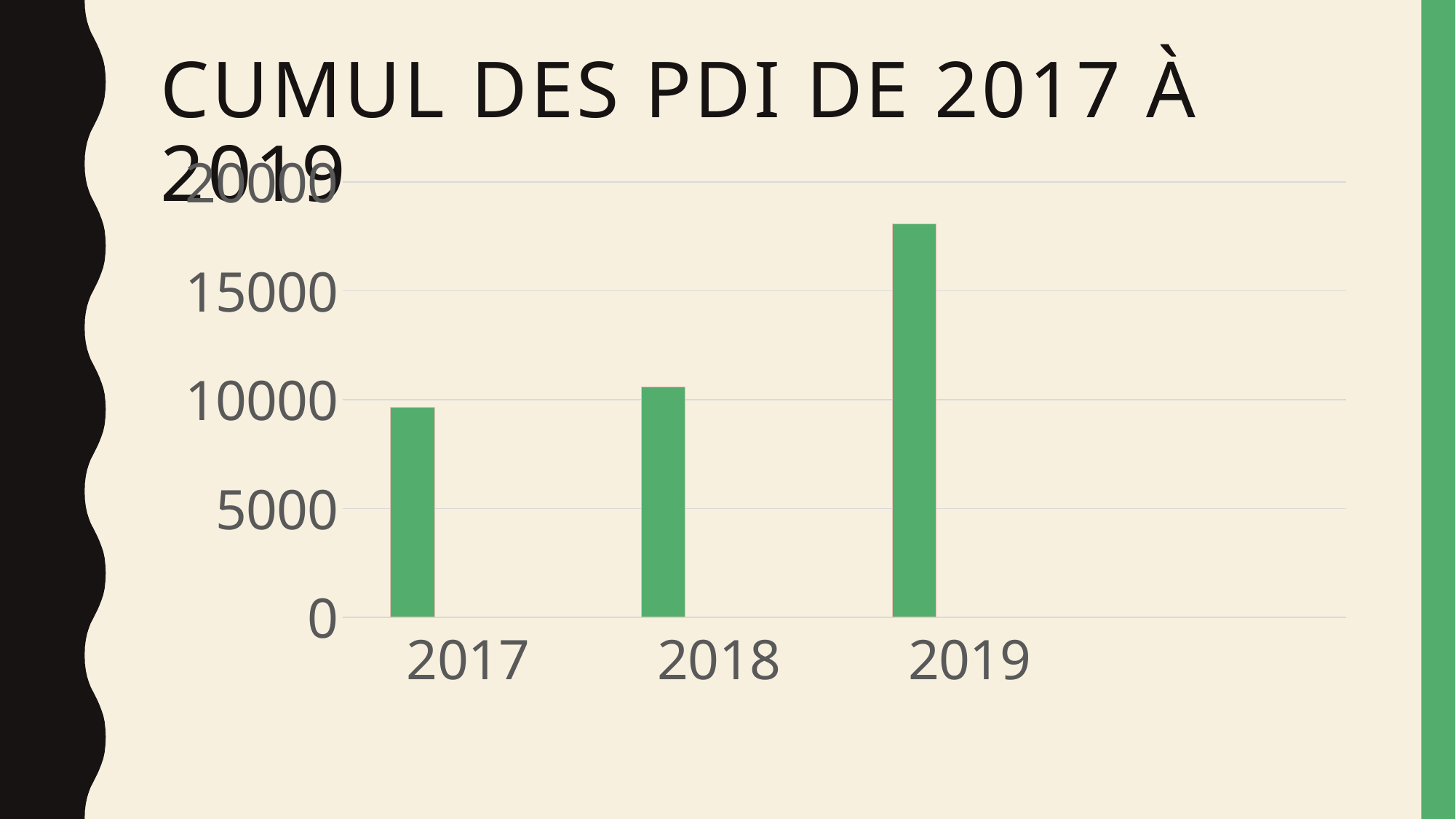
What colour are the bars in the chart? green How many bars (years) are plotted in the chart? 3 What is the title of the chart on the slide? CUMUL DES PDI DE 2017 À 2019 Do the values rise or fall from 2017 to 2019? rise What kind of chart is shown on the slide? bar chart Which year has the lowest bar in the chart? 2017 Is the value for 2017 greater or less than 10000? less Which year has the highest bar in the chart? 2019 Is the value for 2018 greater or less than 10000? greater Is the value for 2019 greater or less than 20000? less Which is larger, the value for 2019 or the value for 2018? 2019